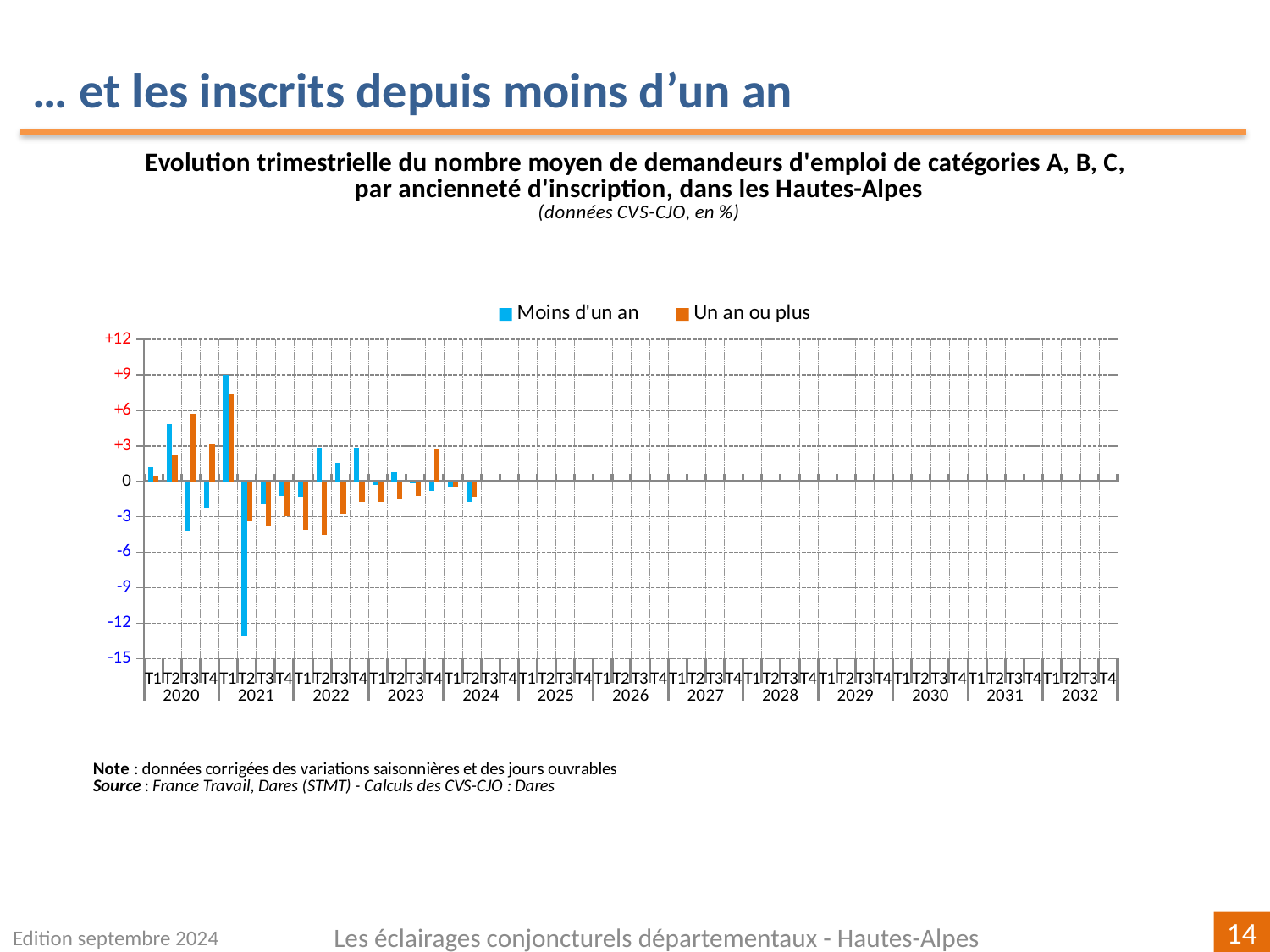
What is the highest value shown on the vertical axis? +12 Is the value for 'Moins d'un an' in T1 2021 greater or less than +6? greater What kind of chart is shown on the slide? bar chart In which quarter does the 'Moins d'un an' series reach its lowest value? T2 2021 Is the value for 'Moins d'un an' in T2 2021 greater or less than -9? less In which quarter does the 'Un an ou plus' series reach its highest value? T1 2021 What are the two series named in the legend? Moins d'un an; Un an ou plus Which colour represents the series 'Un an ou plus'? orange Is the value for 'Un an ou plus' in T3 2020 greater or less than +3? greater In which quarter does the 'Moins d'un an' series reach its highest value? T1 2021 How many series does the legend list? 2 In T1 2021, which series has the larger value, 'Moins d'un an' or 'Un an ou plus'? Moins d'un an